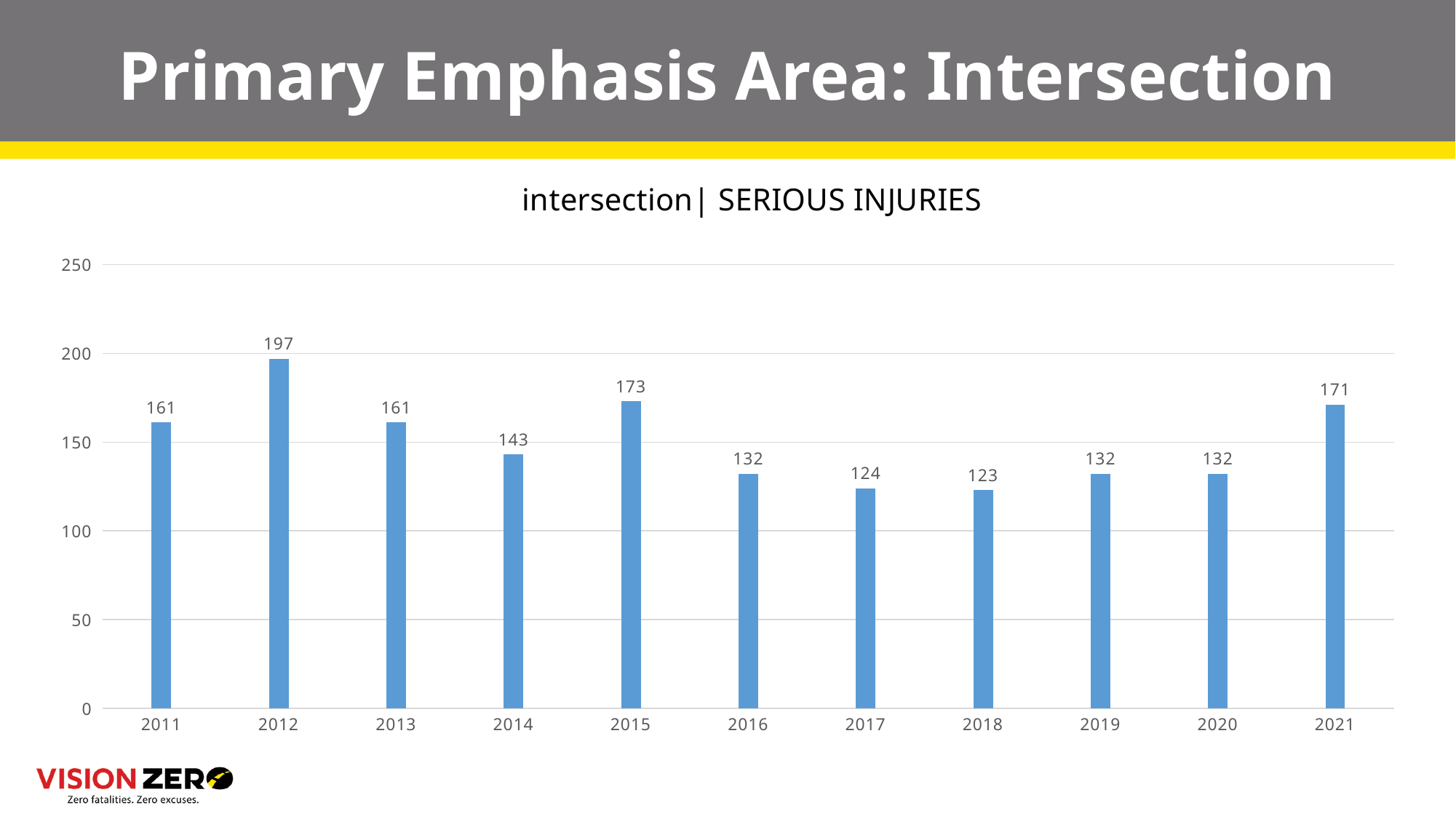
What is the difference between the values for 2012 and 2018? 74 Which year has the highest value? 2012 How many years are shown on the x axis? 11 What kind of chart is shown on the slide? bar chart What is the title of the chart? intersection| SERIOUS INJURIES Which is larger, the value for 2015 or the value for 2021? 2015 What is the value for 2018? 123 Which year has the lowest value? 2018 What is the value for 2021? 171 What is the value for 2012? 197 Is the value for 2014 greater or less than 150? less What is the difference between the values for 2015 and 2014? 30